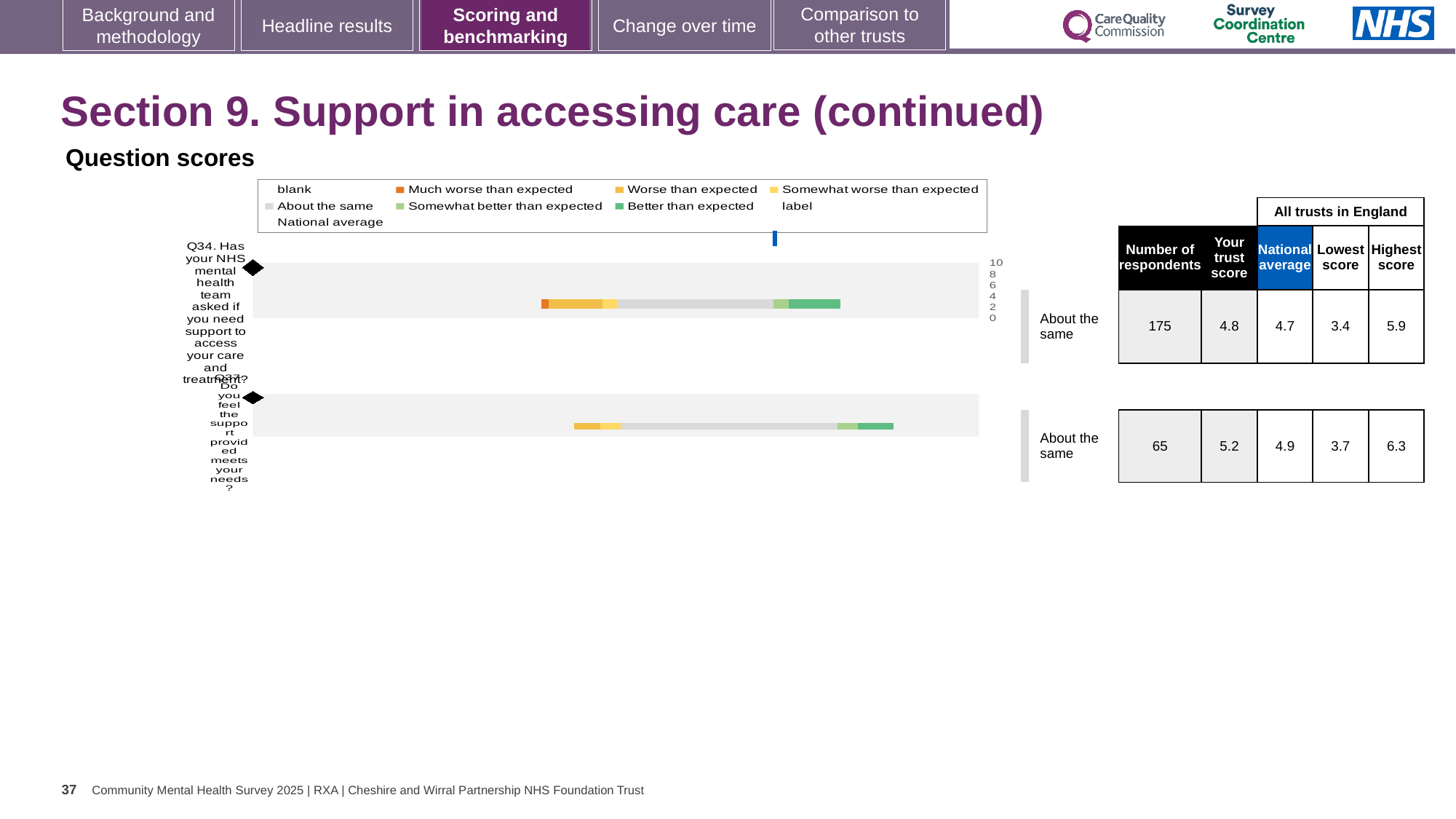
Which question has the higher trust score, Q34 or Q37? Q37 How many questions (categories) are plotted in the chart? 2 What is the trust score for Q37 shown in the table next to the chart? 5.2 What is the number of respondents for Q37? 65 Which legend entry is shown in orange? Much worse than expected What kind of chart is used to show the question scores? bar chart What is the trust score for Q34 shown in the table next to the chart? 4.8 What benchmark category is given for Q34 and Q37? About the same What is the national average for Q34? 4.7 What is the difference between the trust score and the national average for Q37? 0.3 What is the highest score among all trusts in England for Q37? 6.3 What is the lowest score among all trusts in England for Q34? 3.4